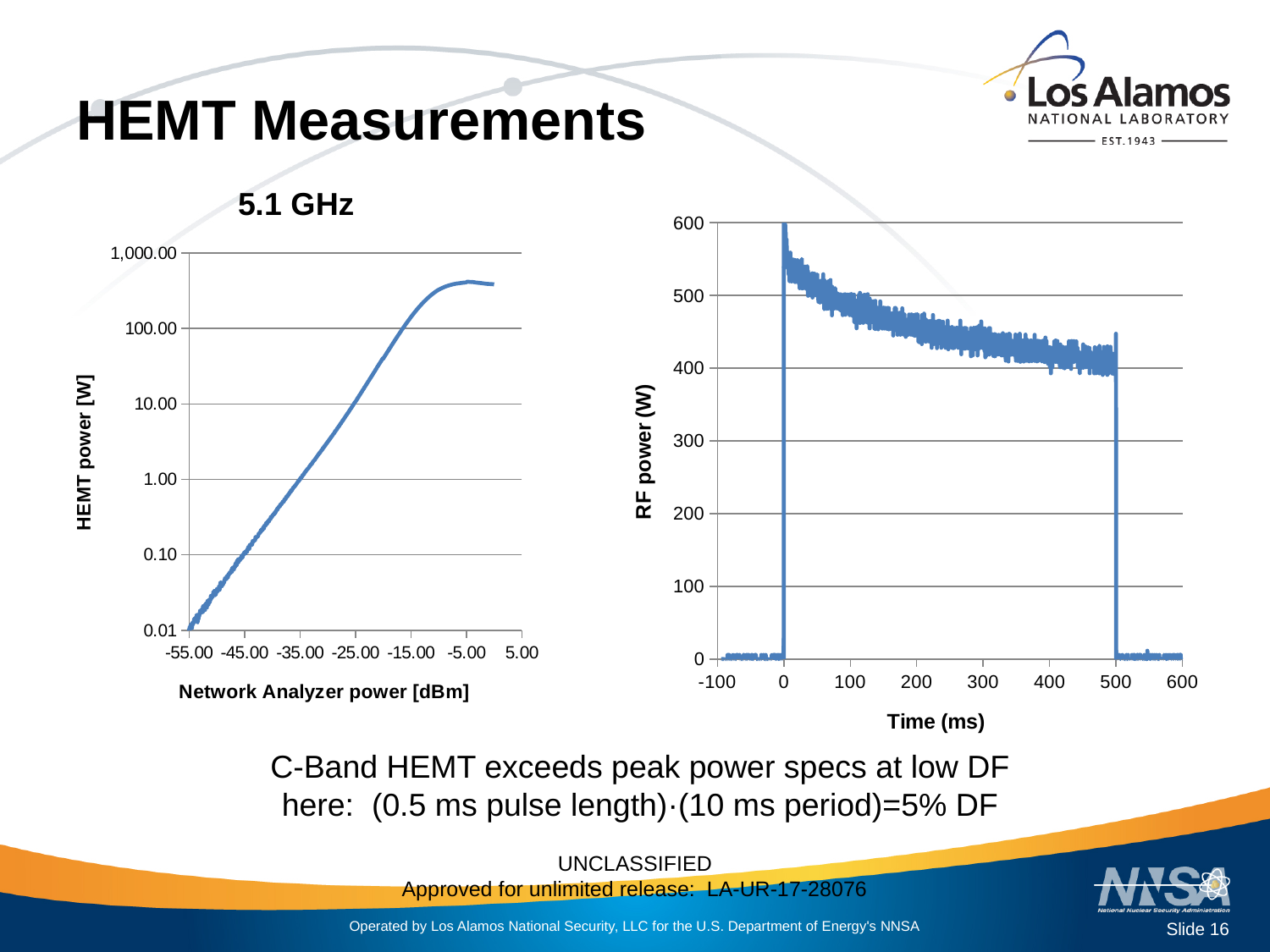
In the left chart, is the HEMT power at -5.00 dBm greater or less than 100.00 W? greater What is the title of the left chart? 5.1 GHz In the left chart, is the HEMT power at -55.00 dBm greater or less than 0.10 W? less What kind of chart is the left chart titled 5.1 GHz? line chart What kind of chart is the right chart with Time (ms) on the x axis? line chart In the left chart, does HEMT power rise or fall as Network Analyzer power increases from -55.00 to -15.00 dBm? rise In the right chart, what is the label of the x axis? Time (ms) In the right chart, is the RF power at 250 ms greater or less than 300 W? greater In the left chart, what is the label of the y axis? HEMT power [W] How many charts are shown on the slide? 2 In the right chart, does RF power rise or fall between 0 ms and 500 ms? fall